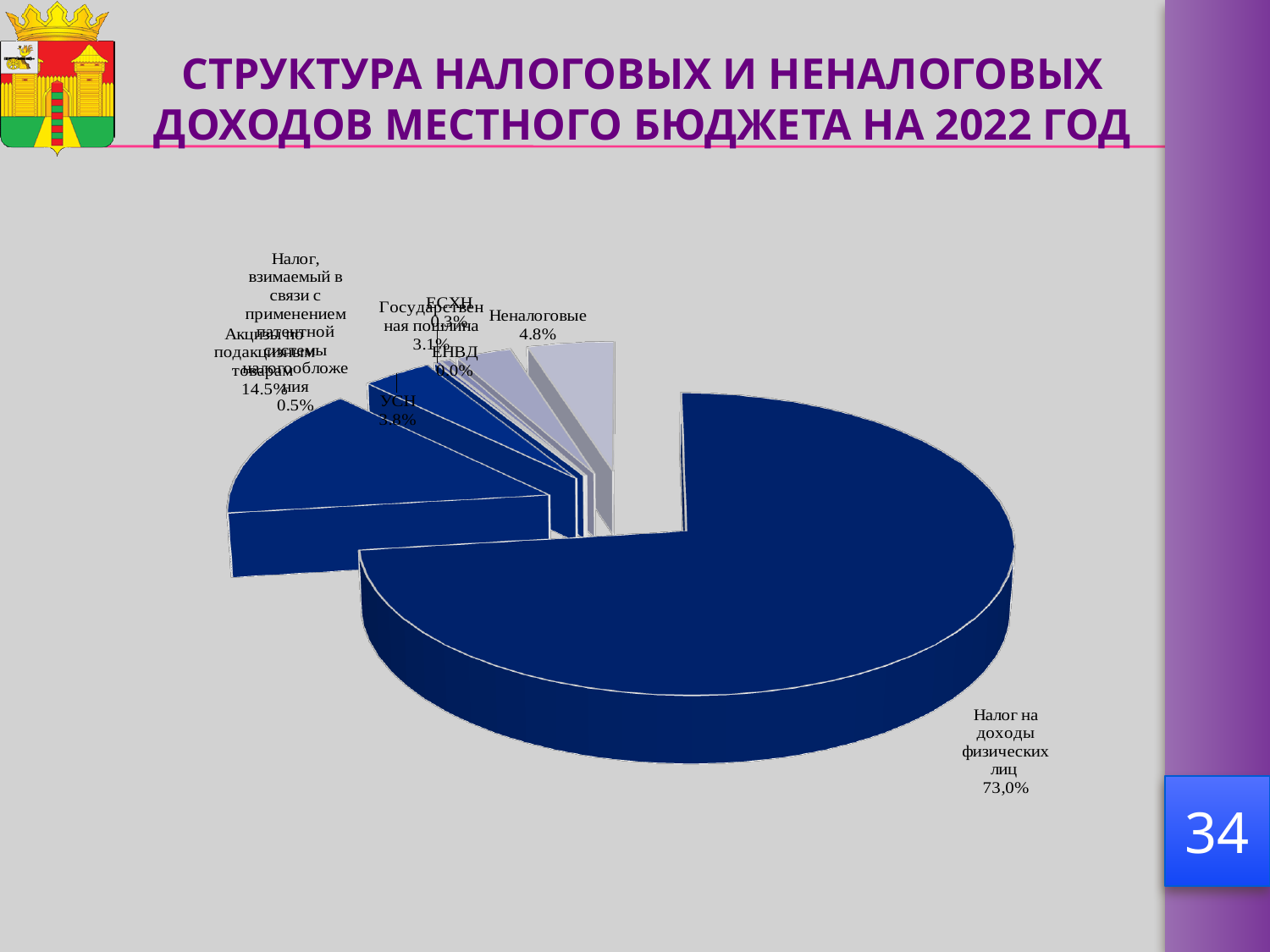
Which category has the smallest value in the chart? ЕНВД What is the value shown for "Неналоговые"? 4.8% What kind of chart is shown on the slide? pie chart What is the difference between the shares of "Акцизы по подакцизным товарам" and "Неналоговые"? 9.7% How many slices does the pie chart have? 8 Which category has the largest slice of the pie? Налог на доходы физических лиц What is the value shown for "Государственная пошлина"? 3.1% What is the title of the slide containing the chart? СТРУКТУРА НАЛОГОВЫХ И НЕНАЛОГОВЫХ ДОХОДОВ МЕСТНОГО БЮДЖЕТА НА 2022 ГОД What is the value shown for "ЕНВД"? 0.0% Which is larger, the share for "Акцизы по подакцизным товарам" or for "Неналоговые"? Акцизы по подакцизным товарам What share of the pie does "Налог на доходы физических лиц" have? 73,0% What is the value shown for "Акцизы по подакцизным товарам"? 14.5%